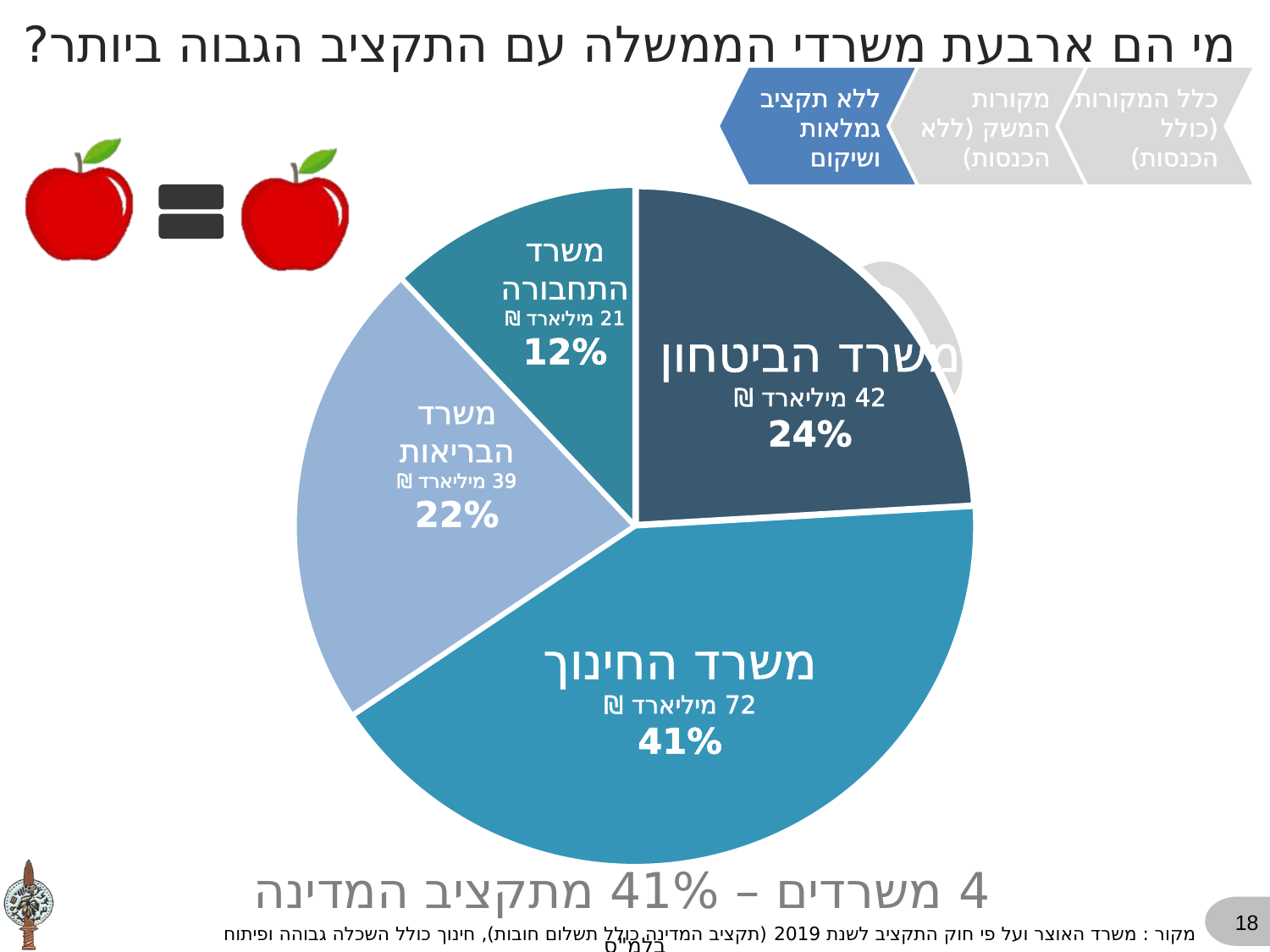
What percentage of the pie is the slice for משרד החינוך (Ministry of Education)? 41% Which ministry has the largest slice of the pie? משרד החינוך Which has a larger budget, משרד הבריאות (Ministry of Health) or משרד התחבורה (Ministry of Transportation)? משרד הבריאות How many slices does the pie chart have? 4 What budget value is printed for משרד הביטחון (Ministry of Defense)? 42 מיליארד ₪ What is the difference in billions of ₪ between the budgets of משרד הביטחון (42) and משרד הבריאות (39)? 3 What budget value is printed for משרד החינוך (Ministry of Education)? 72 מיליארד ₪ What percentage of the pie is the slice for משרד הביטחון (Ministry of Defense)? 24% Which ministry has the smallest slice of the pie? משרד התחבורה What percentage of the pie is the slice for משרד הבריאות (Ministry of Health)? 22% What kind of chart is shown on the slide? pie chart